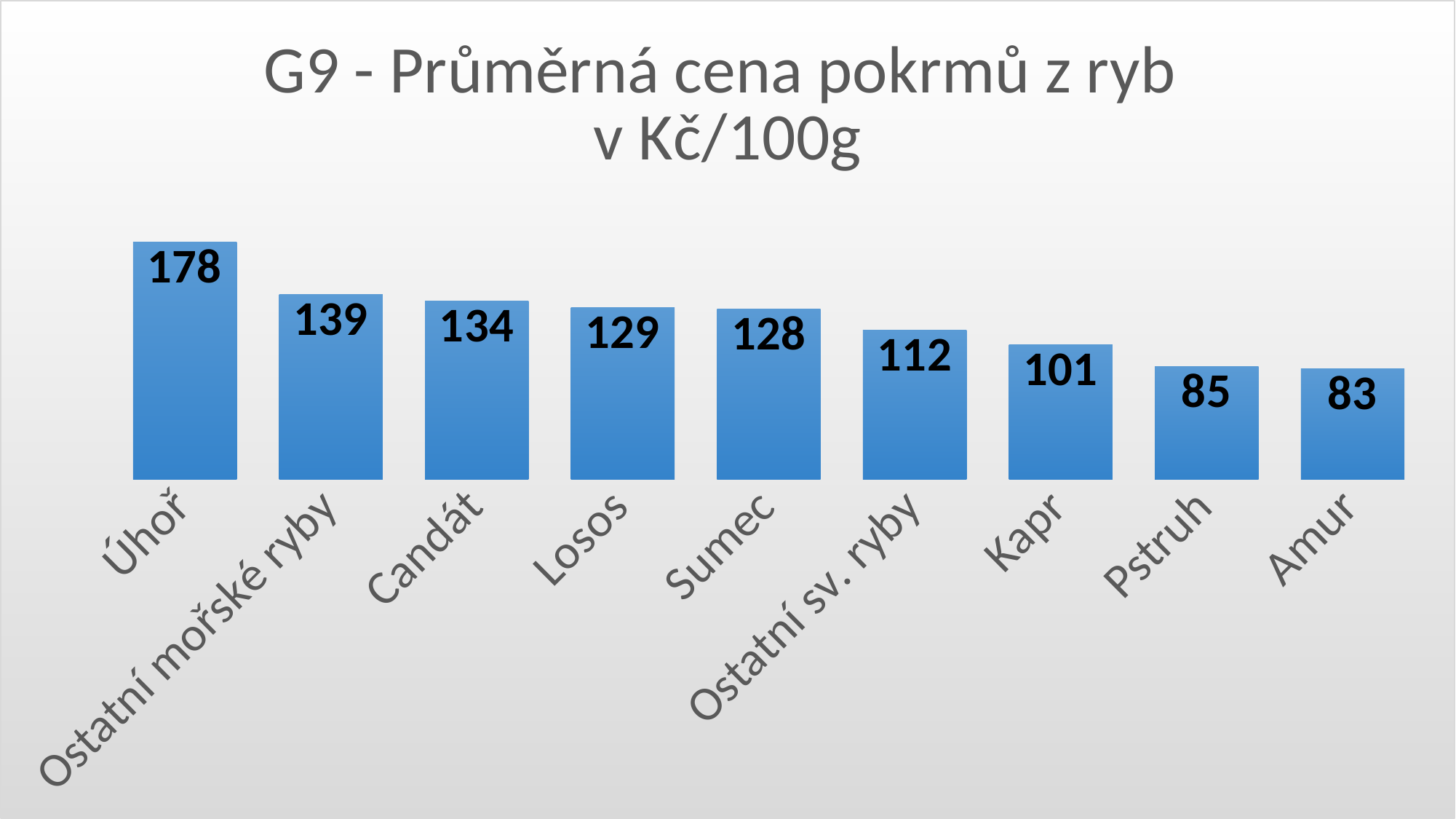
Which category has the highest value? Úhoř What is the difference between the values for Ostatní mořské ryby and Candát? 5 Which is larger, the value for Sumec or the value for Pstruh? Sumec What is the value for Kapr? 101 Which category has the lowest value? Amur What kind of chart is shown? bar chart What is the title of the chart? G9 - Průměrná cena pokrmů z ryb v Kč/100g How many categories are shown in the chart? 9 What is the value for Ostatní sv. ryby? 112 What is the value for Losos? 129 What is the value for Úhoř? 178 What is the difference between the values for Úhoř and Amur? 95